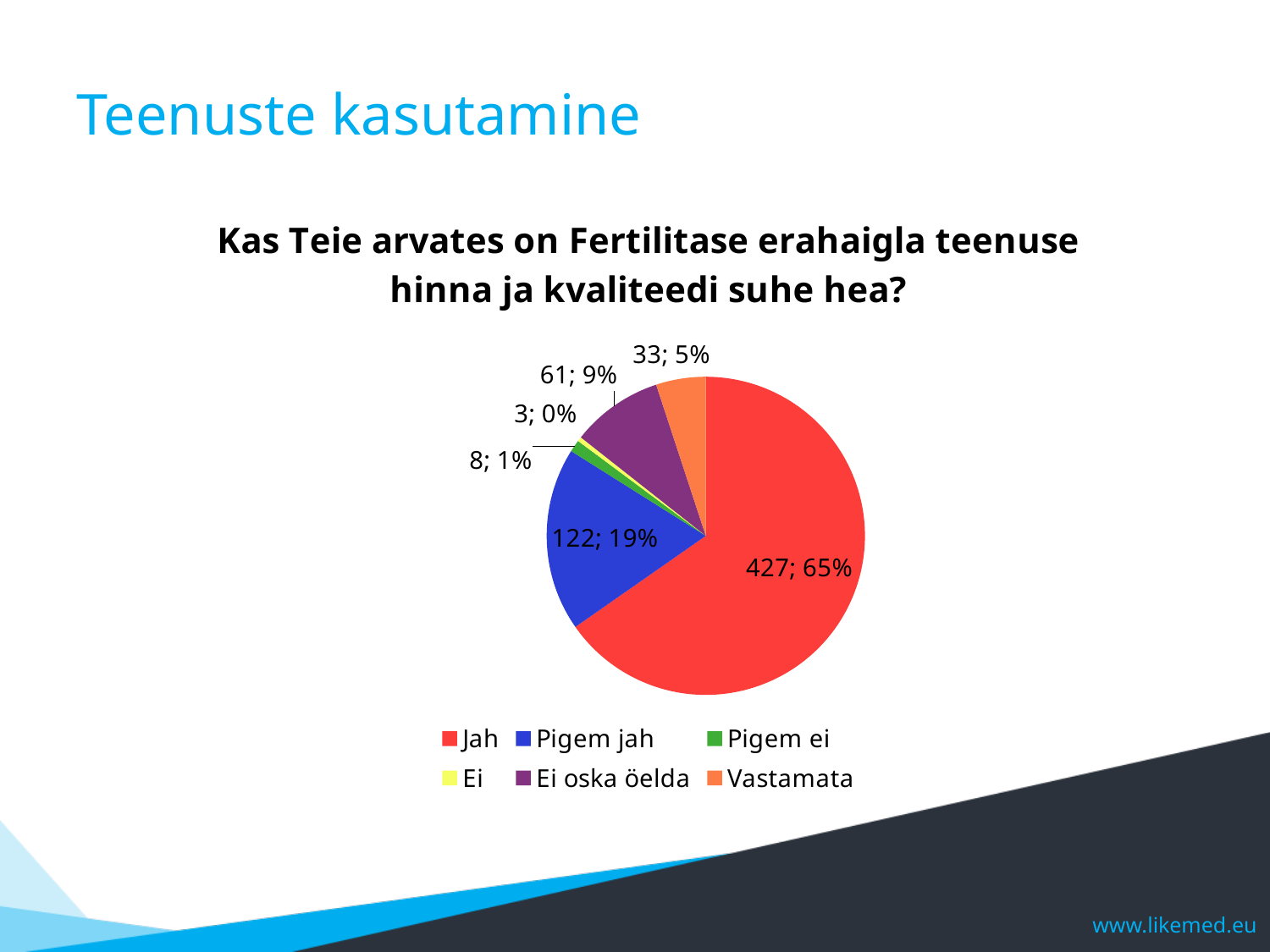
How many categories does the legend of the pie chart list? 6 What percentage share does the "Jah" slice have? 65% Which category has the largest slice of the pie? Jah What is the difference in count between "Jah" and "Pigem jah"? 305 What percentage share does the "Ei oska öelda" slice have? 9% What is the count shown for the "Pigem jah" slice? 122 Which slice is larger, "Ei oska öelda" or "Vastamata"? Ei oska öelda What is the count shown for the "Jah" slice? 427 What kind of chart is shown on the slide? pie chart What is the count shown for the "Vastamata" slice? 33 Which category has the smallest slice of the pie? Ei What colour is the "Pigem jah" slice? blue